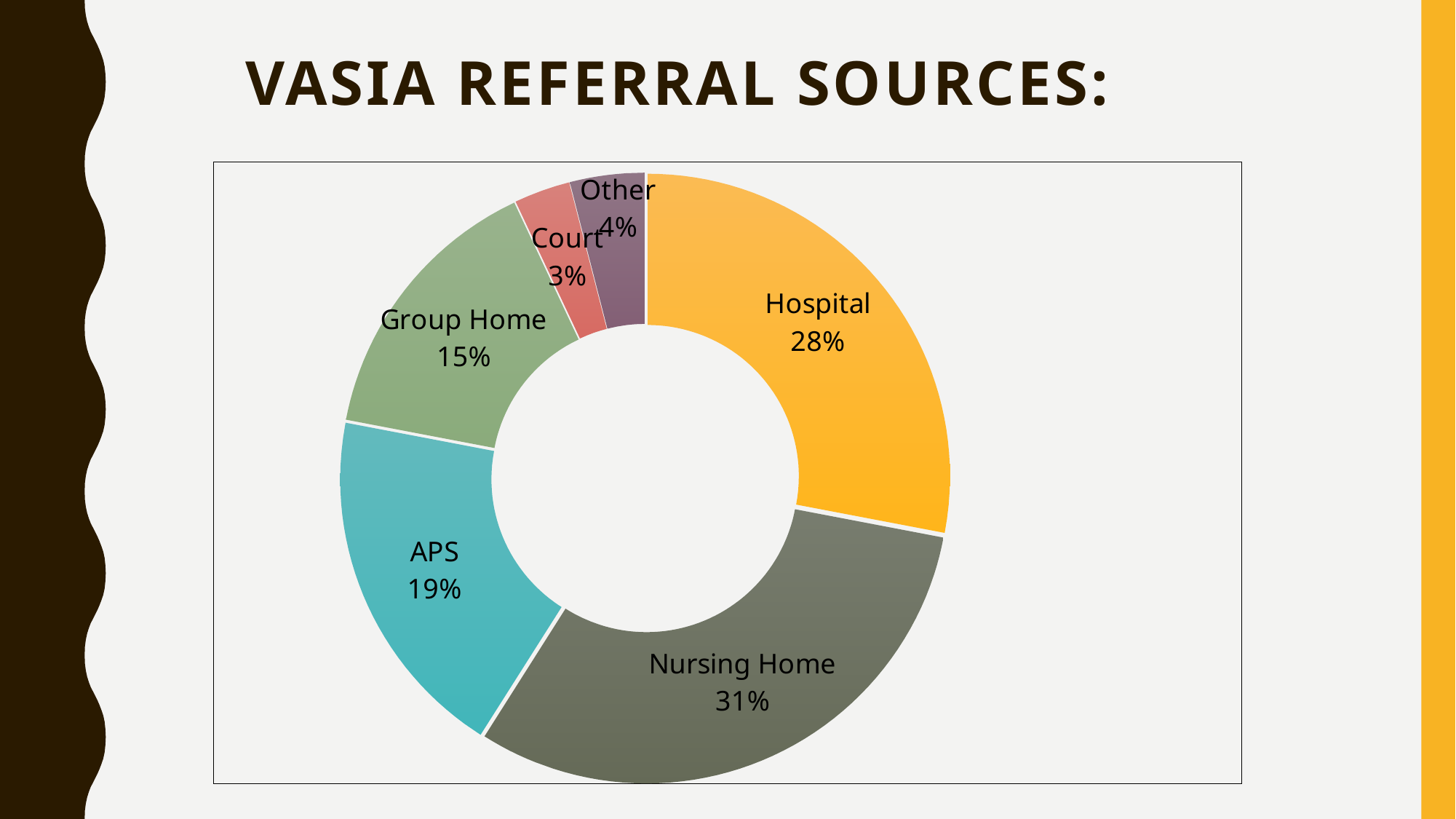
What share of referrals comes from Court? 3% Which is larger, the share for APS or the share for Group Home? APS What share of referrals comes from Group Home? 15% What is the title of the slide? VASIA REFERRAL SOURCES: What share of referrals comes from Nursing Home? 31% What share of referrals comes from APS? 19% What share of referrals comes from Hospital? 28% How many referral source categories are shown in the chart? 6 Which referral source has the smallest share? Court Which referral source has the largest share? Nursing Home What is the difference in percentage points between Nursing Home and Hospital? 3 What kind of chart is shown on the slide? Doughnut (pie) chart